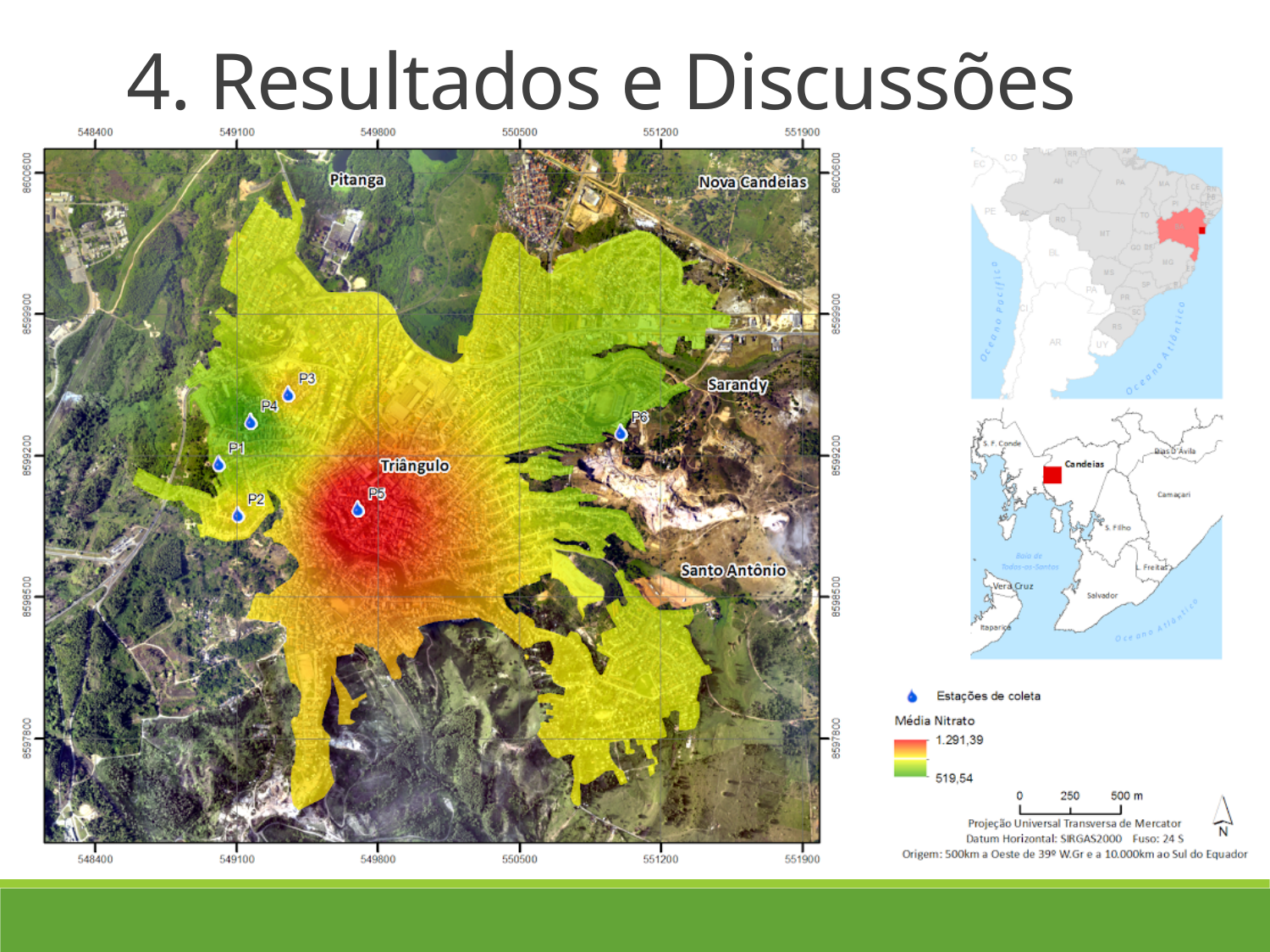
Which neighbourhood label sits at the centre of the red high-nitrate zone? Triângulo How many collection stations (Estações de coleta) are marked on the map? 6 What kind of visualisation is shown on the slide? map (heat map of average nitrate) What is the lowest value shown on the "Média Nitrato" colour legend? 519,54 What is the highest value shown on the "Média Nitrato" colour legend? 1.291,39 What is the largest distance marked on the scale bar? 500 m What does the blue drop symbol in the legend represent? Estações de coleta Which collection station lies in the red zone of highest average nitrate? P5 What is the difference between the highest and lowest values on the "Média Nitrato" legend? 771,85